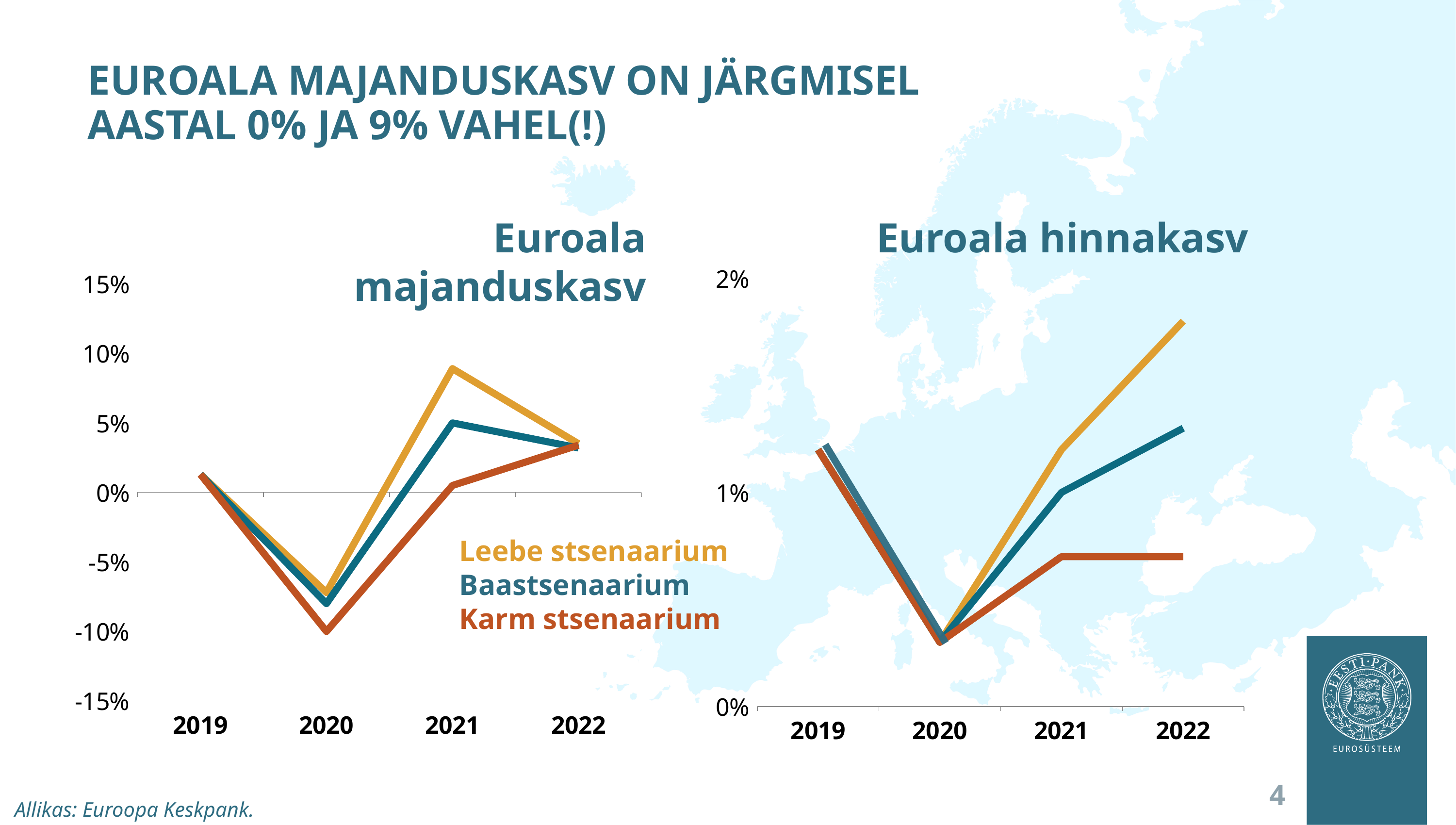
In the "Euroala majanduskasv" chart, which scenario has the lowest value in 2020? Karm stsenaarium In the "Euroala hinnakasv" chart, which scenario has the highest value in 2022? Leebe stsenaarium In the "Euroala majanduskasv" chart, is the 2021 value for Leebe stsenaarium greater or less than 5%? greater In the "Euroala majanduskasv" chart, which scenario has the highest value in 2021? Leebe stsenaarium In the "Euroala hinnakasv" chart, is the 2022 value for Karm stsenaarium greater or less than 1%? less In the "Euroala majanduskasv" chart, is the 2020 value for Karm stsenaarium greater or less than -5%? less What is the title of the chart on the right side of the slide? Euroala hinnakasv How many years are plotted on the x axis of the "Euroala hinnakasv" chart? 4 How many series does the legend list for the charts on the slide? 3 In the "Euroala hinnakasv" chart, does the Leebe stsenaarium line rise or fall from 2020 to 2022? rise In the "Euroala majanduskasv" chart, which is larger in 2021: Leebe stsenaarium or Karm stsenaarium? Leebe stsenaarium What kind of chart is the "Euroala majanduskasv" chart? line chart